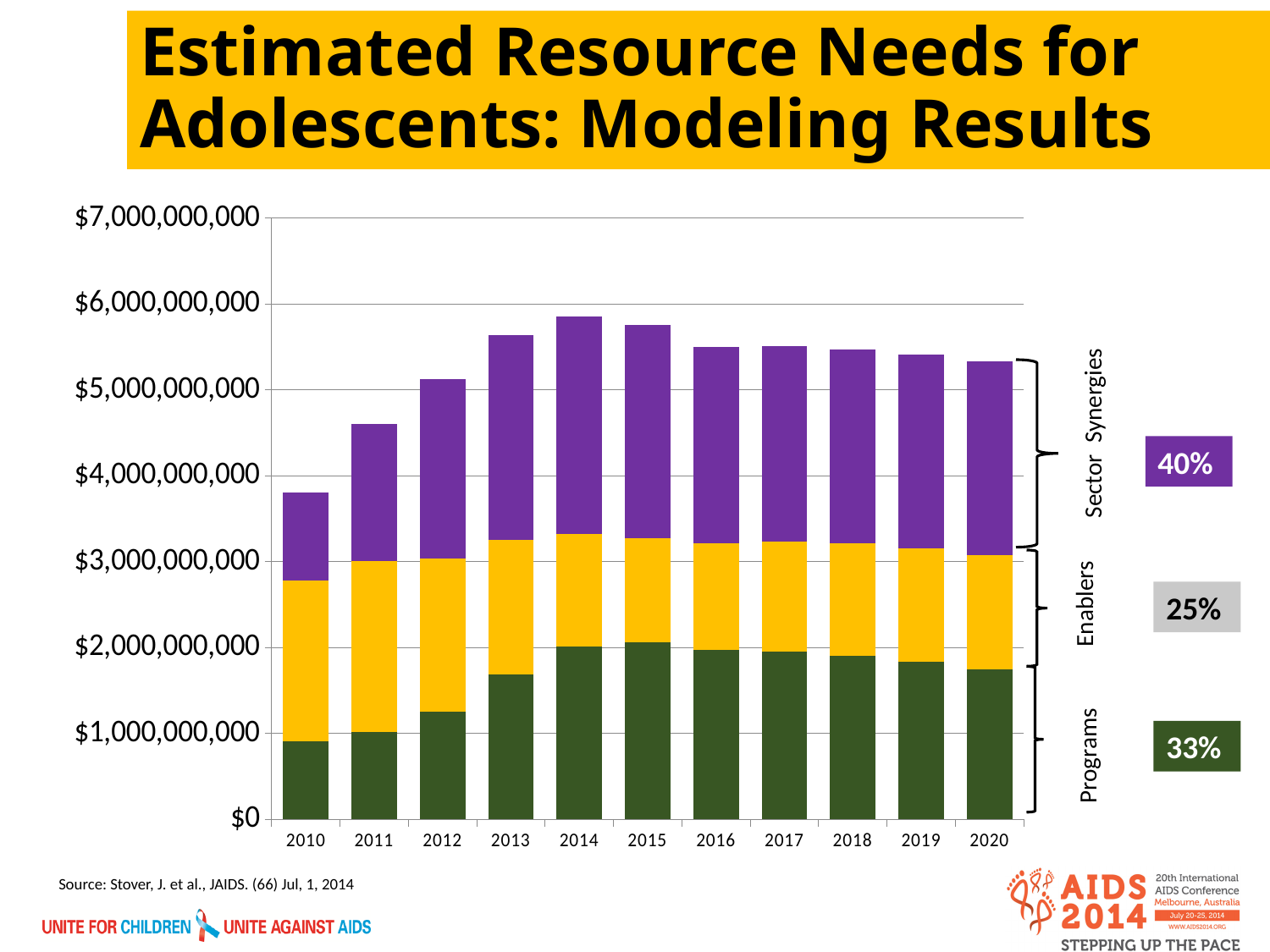
Is the total value for 2010 greater or less than $4,000,000,000? less Which year has the larger total, 2011 or 2012? 2012 How many years are shown on the x axis of the chart? 11 How do the total bar heights change from 2010 to 2014? They rise What kind of chart is shown on the slide? Stacked bar chart Which year has the tallest stacked bar (highest total resource need)? 2014 Is the total value for 2014 greater or less than $5,000,000,000? greater Which year has the shortest stacked bar (lowest total resource need)? 2010 Is the Programs value for 2010 greater or less than $1,000,000,000? less What colour represents the Programs segment in the chart? Green What percentage is shown next to the Sector Synergies label? 40% How many series (segments) make up each stacked bar? 3